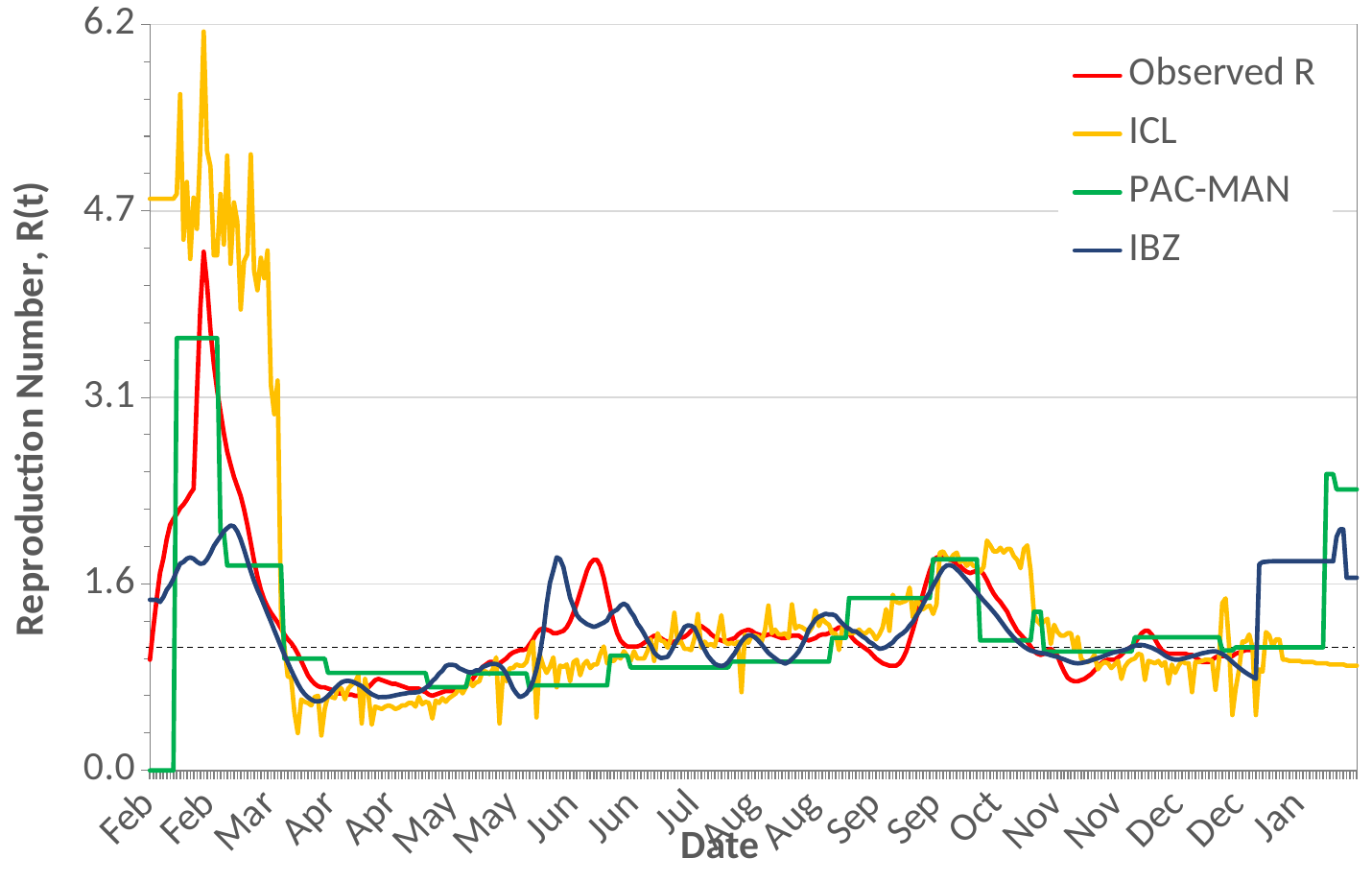
Which series reaches the highest value on the chart? ICL Is the peak value of the ICL series in February greater or less than 4.7? greater Is the peak value of the Observed R series in February greater or less than 3.1? greater How many series does the legend list? 4 What kind of chart is shown on the slide? line chart Does the Observed R series rise or fall from its February peak to April? fall Is the peak value of the IBZ series in February greater or less than 3.1? less What is the title of the vertical axis? Reproduction Number, R(t) In January, which series is larger, PAC-MAN or ICL? PAC-MAN In early February, which series is larger, ICL or IBZ? ICL Which series starts at 0.0 at the beginning of February? PAC-MAN